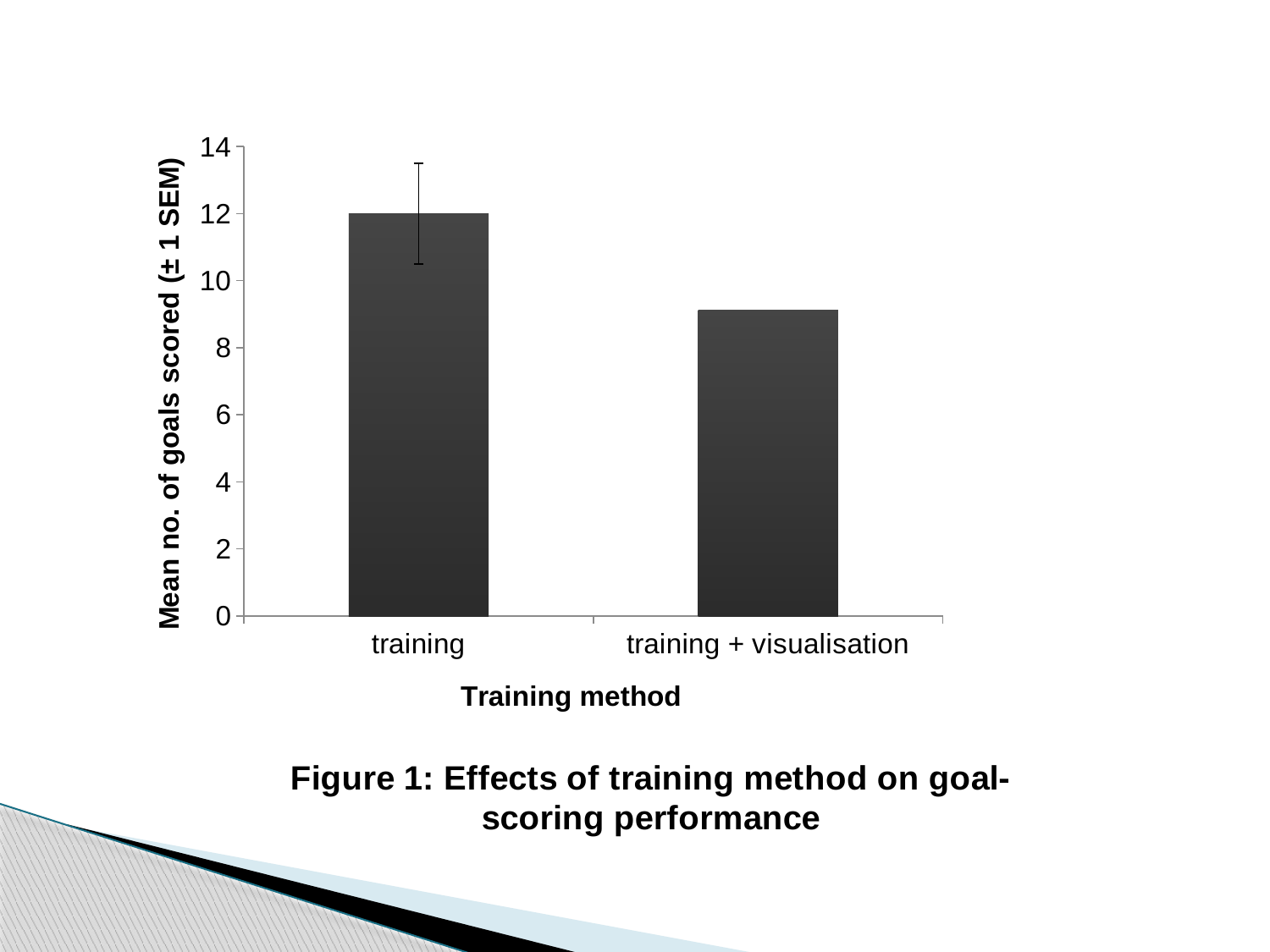
What kind of chart is shown on the slide? bar chart Which training method has the lowest mean number of goals scored? training + visualisation What is the label of the x axis? Training method Is the mean number of goals scored for training + visualisation greater or less than 10? less Which has a larger mean number of goals scored: training or training + visualisation? training What is the mean number of goals scored for the training method? 12 Is the mean number of goals scored for training + visualisation greater or less than 8? greater Which training method has the highest mean number of goals scored? training How many training methods are plotted on the x axis? 2 Do the values rise or fall from the training bar to the training + visualisation bar? fall What is the label of the y axis? Mean no. of goals scored (± 1 SEM)